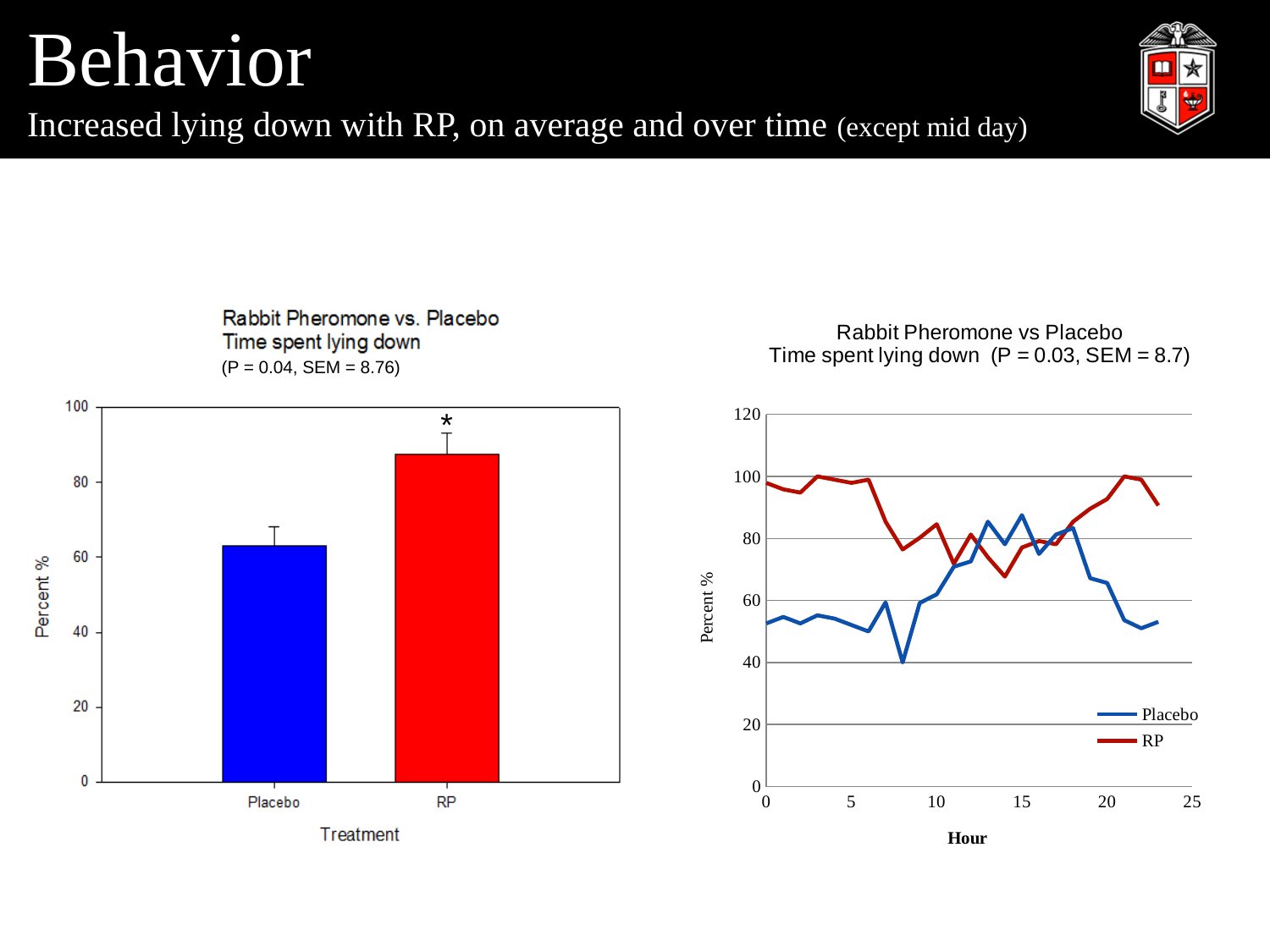
In the right line chart, does the Placebo line rise or fall between hour 18 and hour 23? fall In the left bar chart, is the value for Placebo greater or less than 80? less In the right line chart, is the RP value at hour 0 greater or less than 80? greater In the left bar chart, which treatment has the higher percent of time spent lying down? RP In the left bar chart, is the value for RP greater or less than 80? greater In the left bar chart, what colour is the RP bar? red In the right line chart, which series is higher at hour 5, Placebo or RP? RP In the right line chart, how many series does the legend list? 2 In the left bar chart, how many treatment categories are shown on the x axis? 2 What type of chart is the left chart titled 'Rabbit Pheromone vs. Placebo Time spent lying down'? bar chart In the left bar chart, what is the x-axis title? Treatment What type of chart is the right chart titled 'Rabbit Pheromone vs Placebo Time spent lying down'? line chart